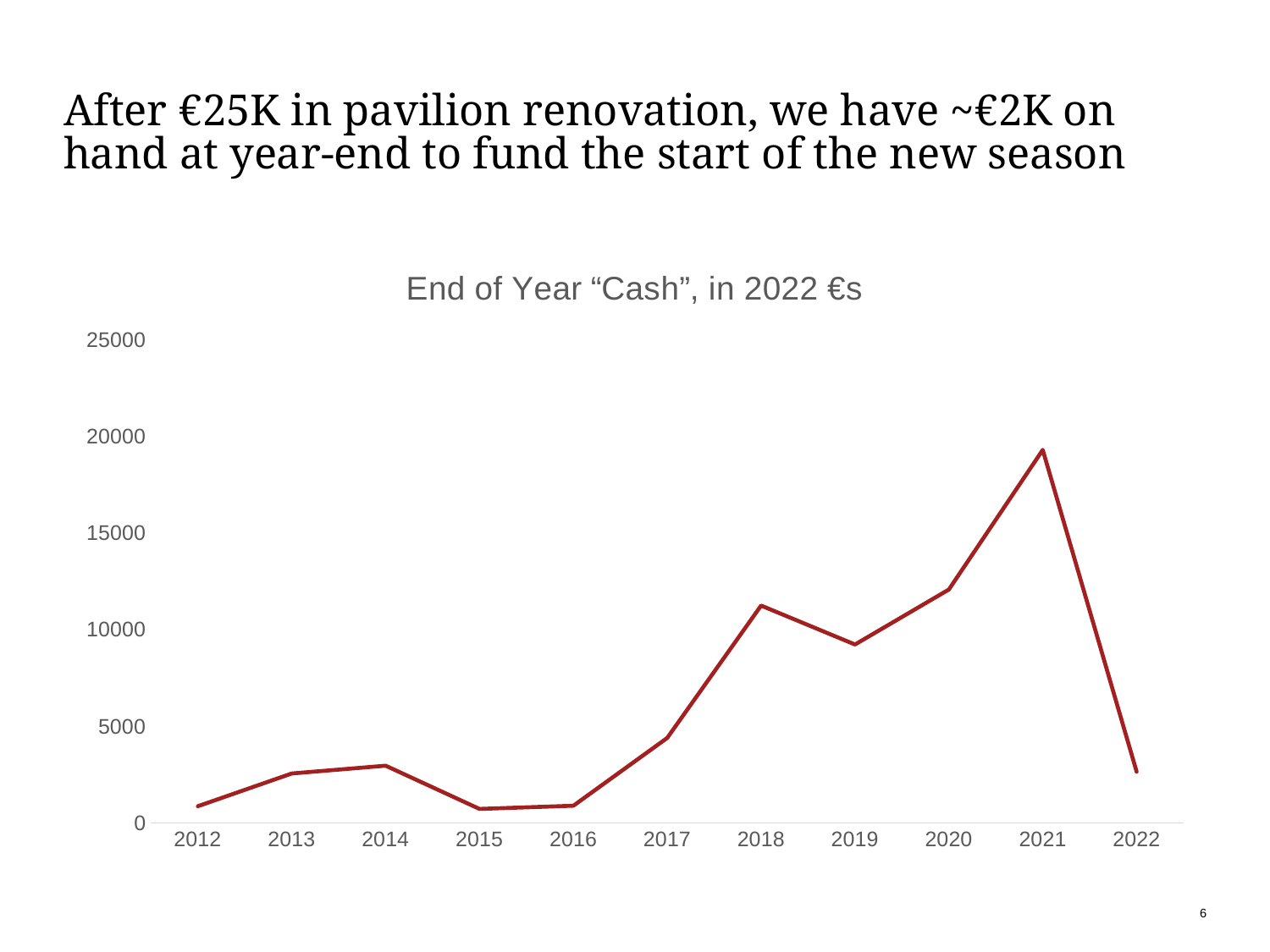
Which year has the larger value, 2018 or 2019? 2018 Is the value for 2017 greater or less than 5000? less Is the value for 2022 greater or less than 5000? less Does the line rise or fall between 2021 and 2022? fall What is the title of the chart? End of Year “Cash”, in 2022 €s What kind of chart is shown on the slide? line chart How many years are plotted along the x axis of the chart? 11 Is the value for 2021 greater or less than 15000? greater Which year has the larger value, 2014 or 2015? 2014 Which year has the highest end-of-year cash value? 2021